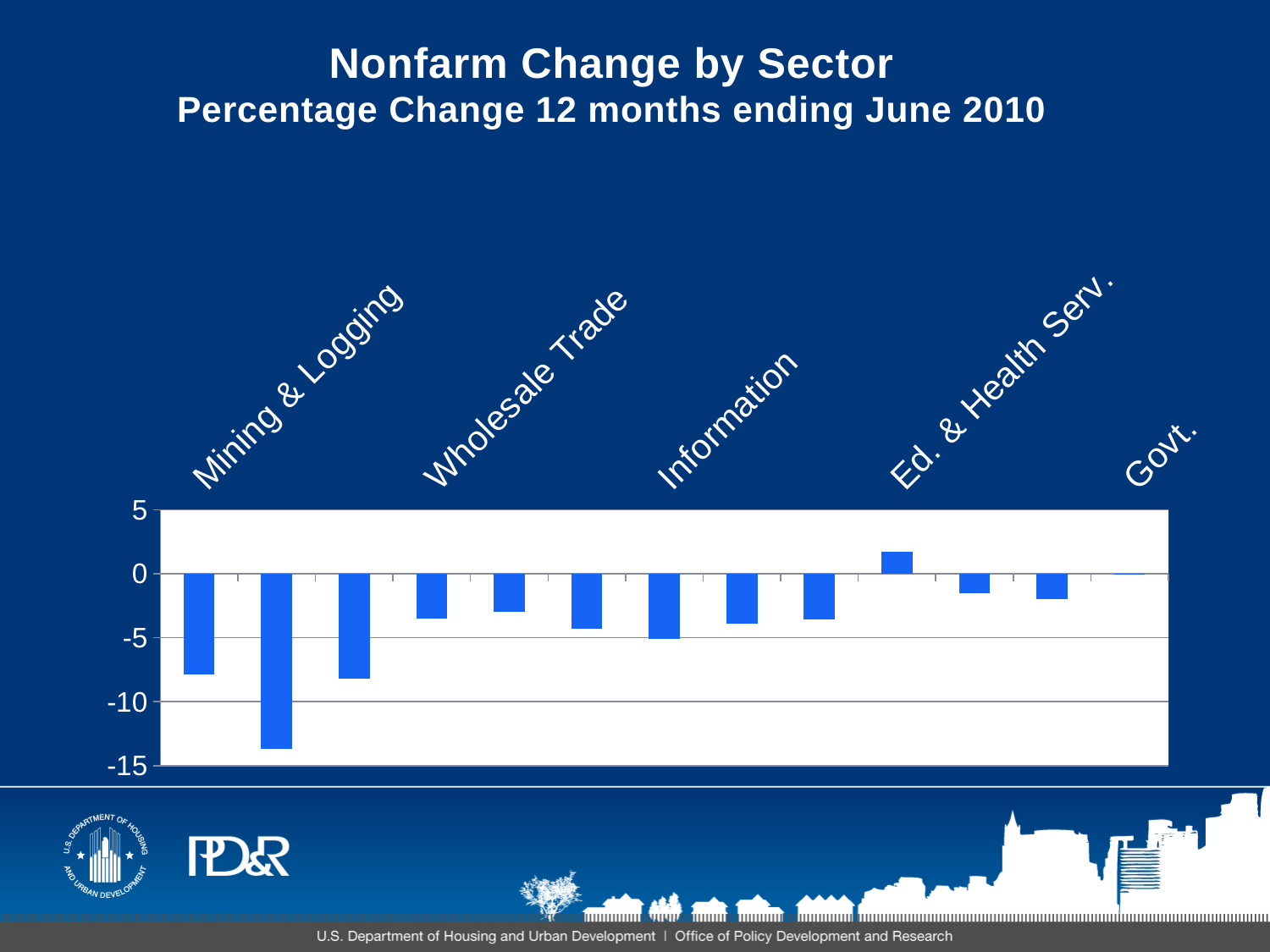
How many bars are plotted in the chart? 13 How many sector labels are printed along the x axis? 5 Is the value for Information greater or less than -10? greater Is the value for Ed. & Health Serv. greater or less than 0? greater What is the title of the chart? Nonfarm Change by Sector Of the labeled sectors, which has the lowest value? Mining & Logging Which is larger, the value for Mining & Logging or the value for Wholesale Trade? Wholesale Trade What kind of chart is shown on the slide? bar chart Is the value for Mining & Logging greater or less than -5? less Of the labeled sectors, which has the highest value? Ed. & Health Serv. Which is larger, the value for Ed. & Health Serv. or the value for Information? Ed. & Health Serv.